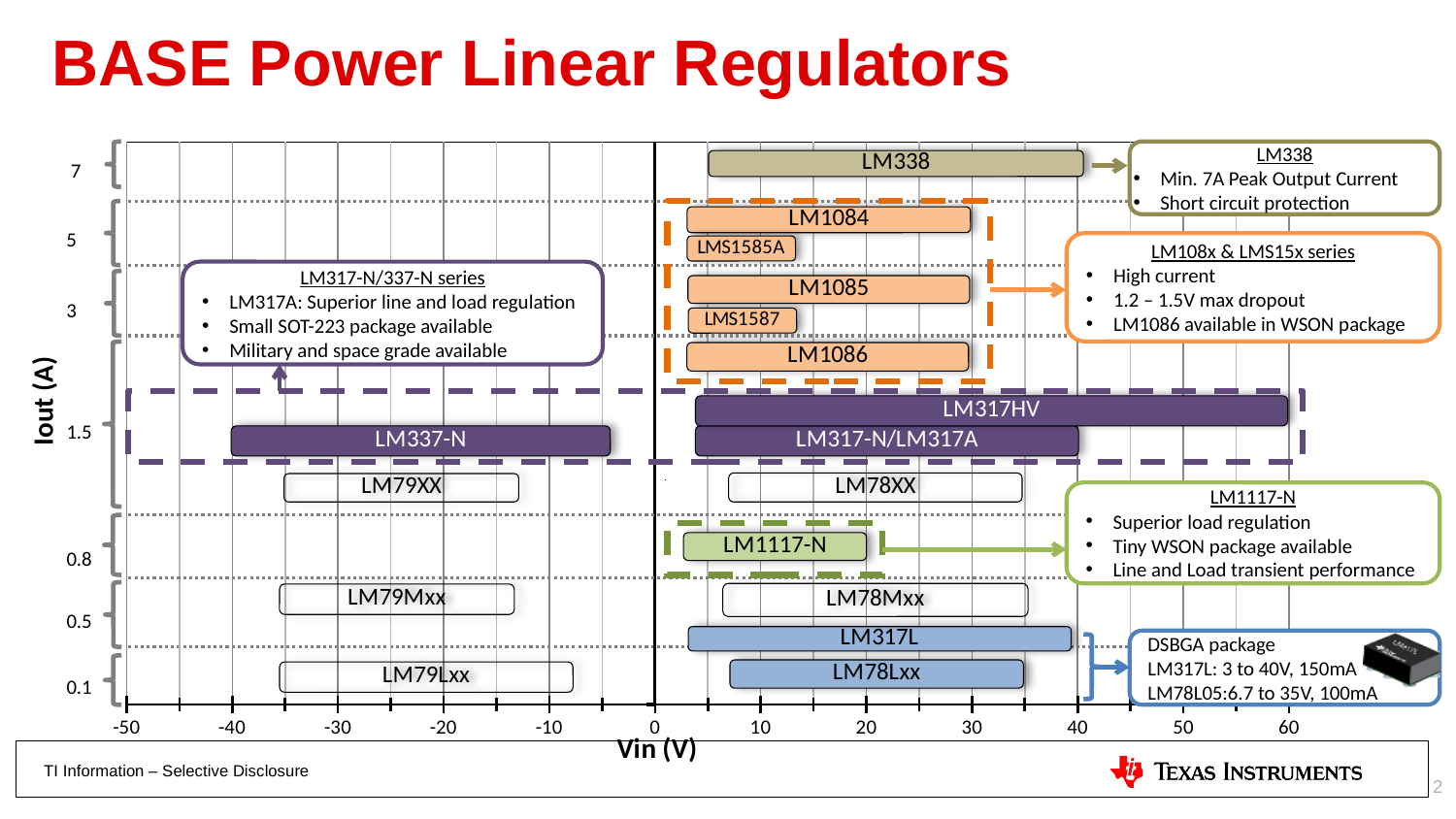
Which is plotted at a higher Iout, LM1084 or LM1086? LM1084 What is the label of the x axis of the chart? Vin (V) Is the maximum Vin of the LM1117-N bar greater or less than 30? less Is the minimum Vin of the LM337-N bar greater or less than -30? less Is the maximum Vin of the LM317HV bar greater or less than 50? greater What is the label of the y axis of the chart? Iout (A) How many regulator bars are plotted on the negative Vin side of the chart? 4 According to the callout on the chart, what output current is given for the LM78L05? 100mA Which bar extends to a higher Vin, LM317HV or LM317-N/LM317A? LM317HV According to the callout on the chart, what input voltage range is given for the LM317L? 3 to 40V Which regulators are plotted at the lowest Iout level (0.1 A) on the chart? LM79Lxx and LM78Lxx Which regulator is plotted at the highest output current (Iout) level on the chart? LM338